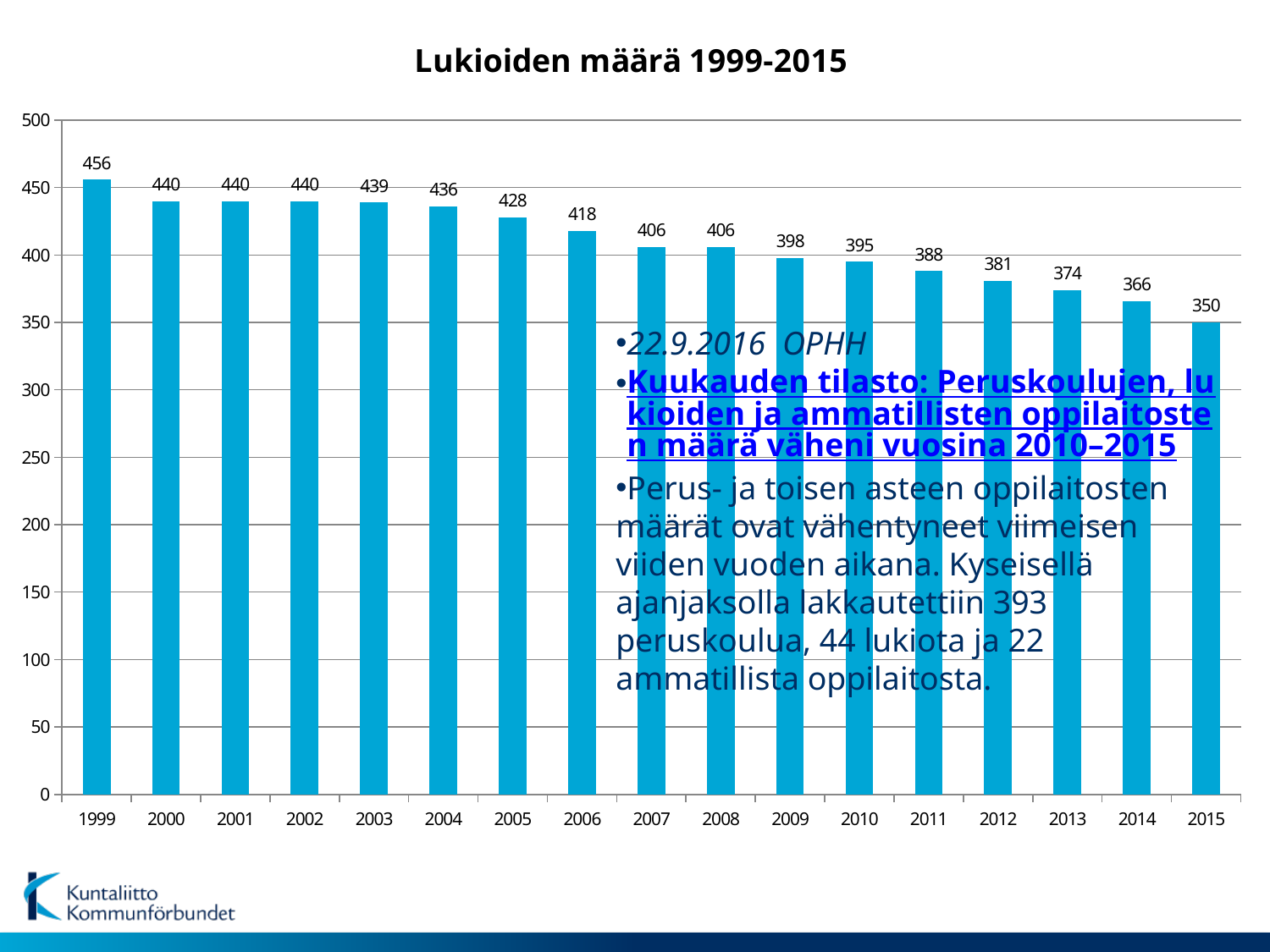
What is the difference between the values for 1999 and 2015? 106 How many years are shown on the x axis? 17 What is the value for 1999? 456 What kind of chart is this? bar chart What is the title of the chart? Lukioiden määrä 1999-2015 Which is larger, the value for 2010 or the value for 2012? 2010 Is the value for 2013 greater or less than 400? less What is the value for 2006? 418 Which year has the highest value? 1999 Do the values rise or fall from 1999 to 2015? fall Which year has the lowest value? 2015 What is the value for 2015? 350